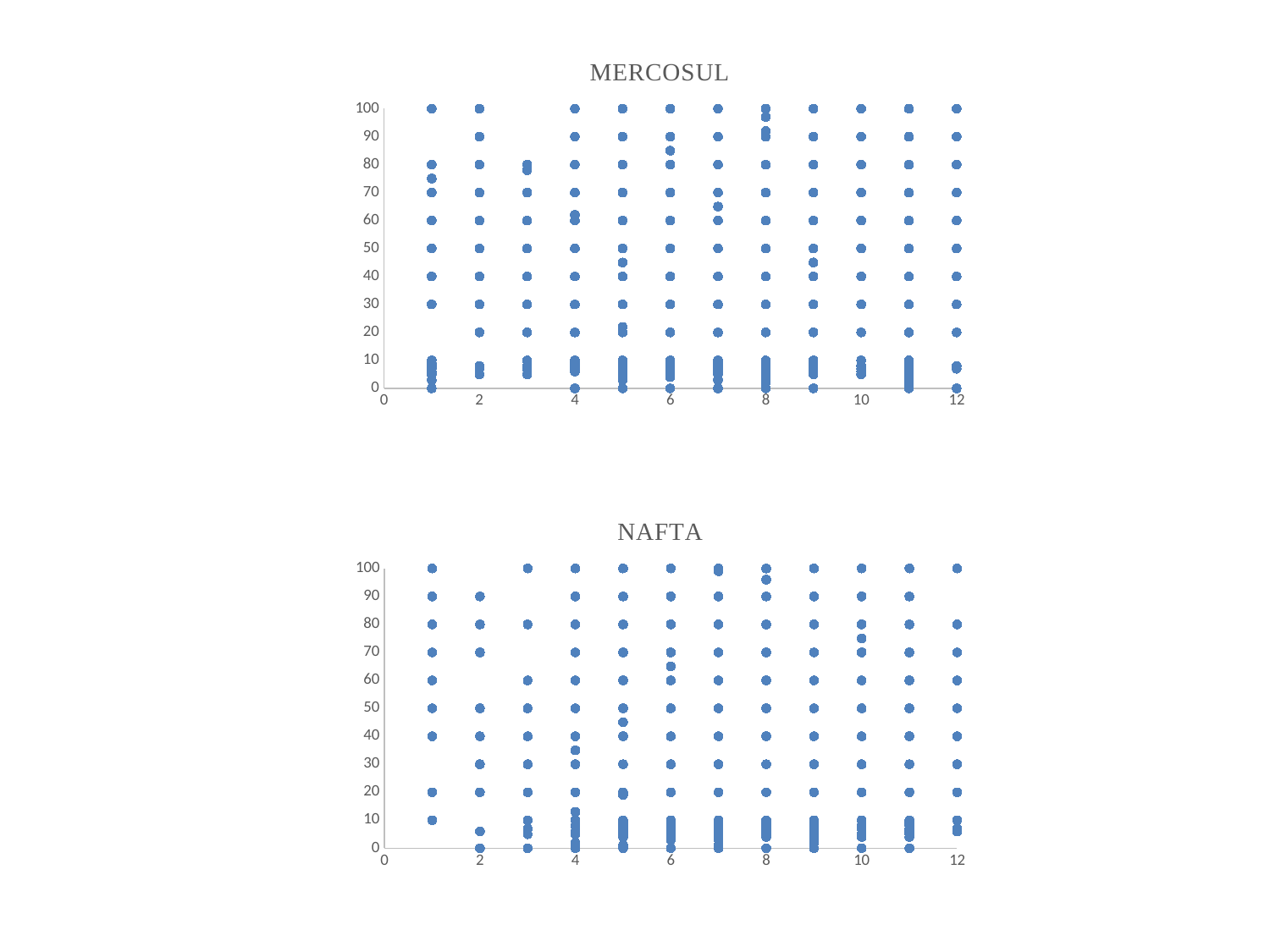
How many distinct x positions have plotted points in the MERCOSUL chart? 12 In the MERCOSUL chart, is the highest point at x = 3 greater or less than 90? less How many charts are shown on the slide? 2 In the MERCOSUL chart, is the highest point at x = 1 greater or less than 90? greater In the NAFTA chart, is the lowest point at x = 1 greater or less than 5? greater What is the highest value shown on the y axis of the NAFTA chart? 100 What is the title of the top chart on the slide? MERCOSUL What is the title of the bottom chart on the slide? NAFTA What is the highest value shown on the x axis of the MERCOSUL chart? 12 What type of chart is the MERCOSUL chart? scatter chart